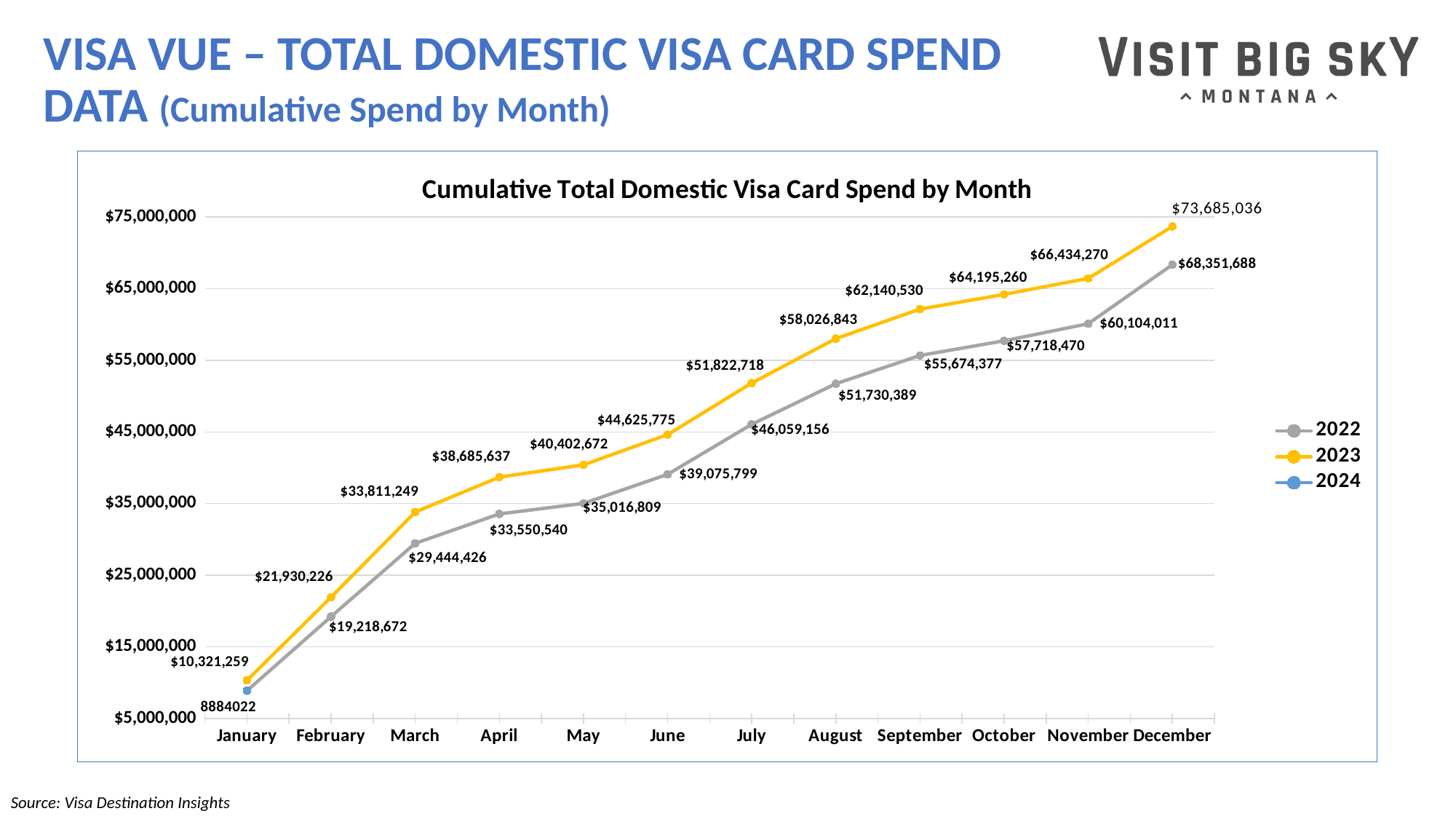
How many series does the legend list? 3 Which month has the highest value for the 2022 series? December What is the difference between the December values for 2023 and 2022? $5,333,348 What kind of chart is this? Line chart What is the difference between the 2023 February and January values? $11,608,967 What is the cumulative 2022 spend shown for July? $46,059,156 Do the 2023 values rise or fall from January to December? Rise What is the cumulative 2023 spend shown for December? $73,685,036 How many months are shown on the x axis? 12 What is the title of the chart? Cumulative Total Domestic Visa Card Spend by Month In March, which series has the higher value, 2022 or 2023? 2023 What value is labeled for the 2024 series in January? 8884022